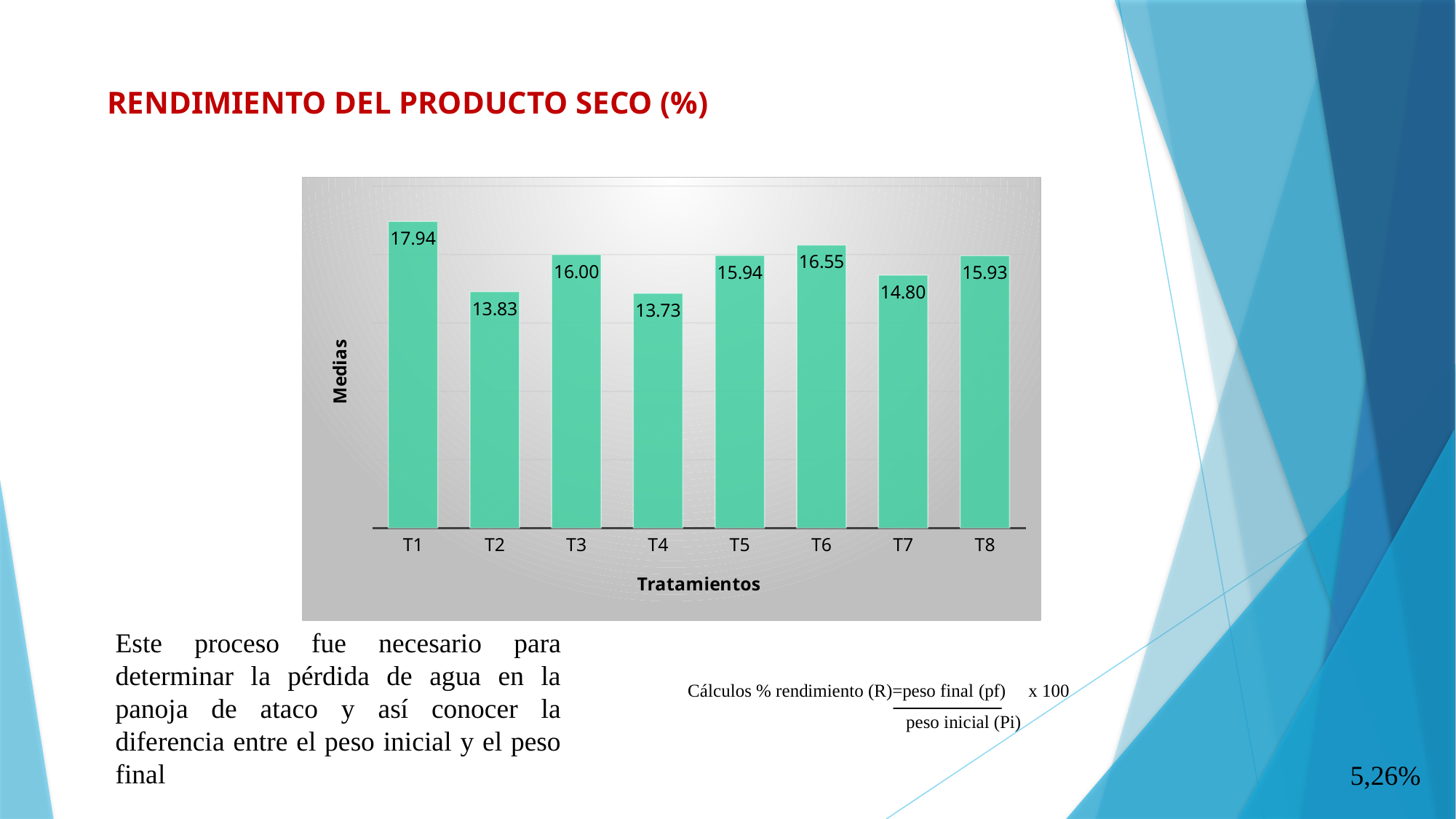
Which has a larger value, T3 or T6? T6 What is the value for T7? 14.80 How many treatments are shown on the x axis? 8 What is the difference between the values for T6 and T7? 1.75 What is the value for T1? 17.94 Which treatment has the lowest value? T4 What is the difference between the values for T1 and T2? 4.11 Which treatment has the highest value? T1 What is the title of the x axis of the chart? Tratamientos What is the value for T6? 16.55 What kind of chart is shown on the slide? Bar chart What is the value for T3? 16.00